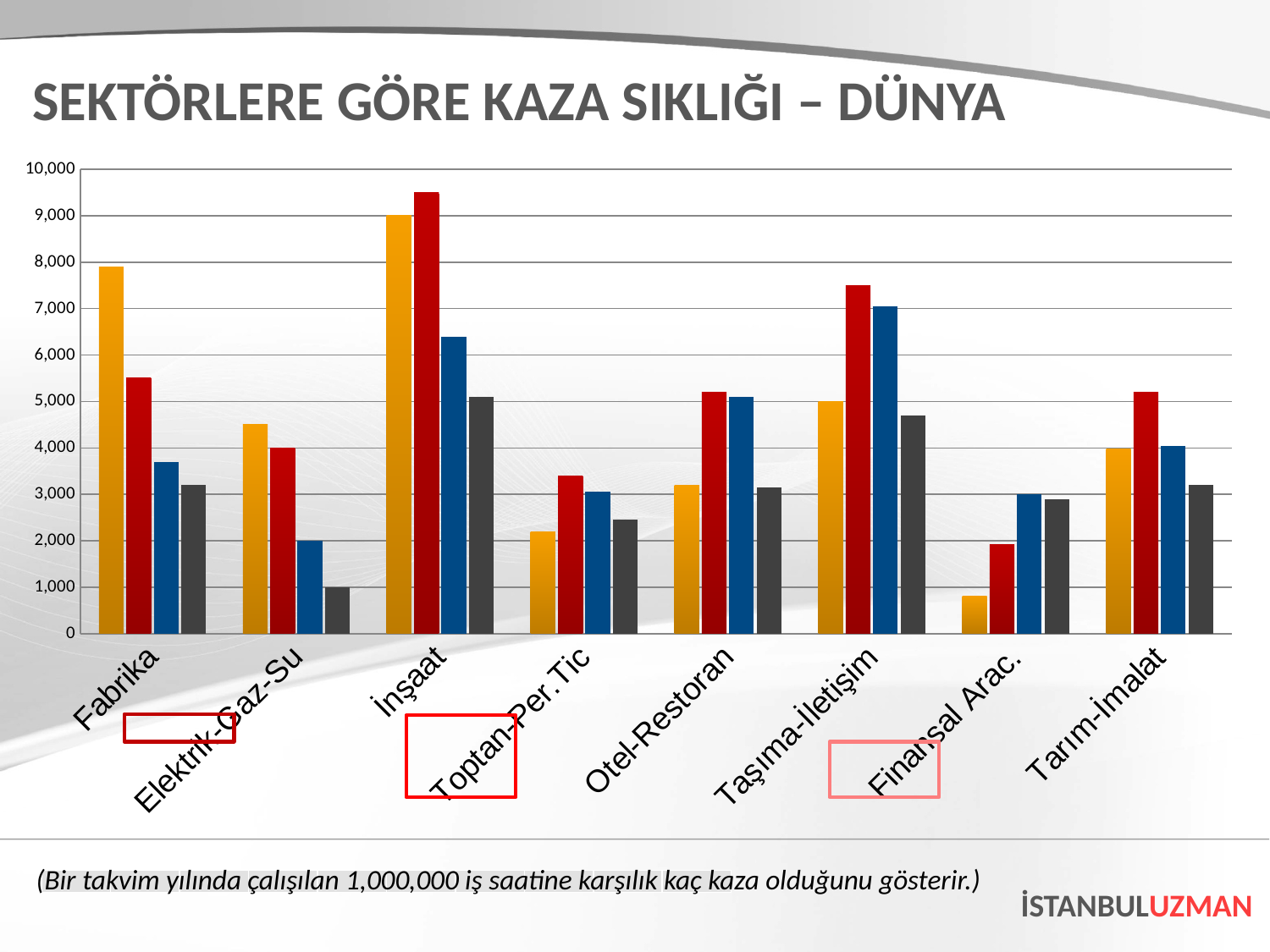
How many bars are plotted for each sector category? 4 Which is larger, the red bar for İnşaat or the red bar for Otel-Restoran? İnşaat Which is larger, the yellow bar for Fabrika or the yellow bar for Elektrik-Gaz-Su? Fabrika Is the yellow bar for Finansal Arac. greater or less than 1,000? less What kind of chart is shown on the slide? bar chart Is the yellow bar for Fabrika greater or less than 7,000? greater What is the title of the chart on the slide? SEKTÖRLERE GÖRE KAZA SIKLIĞI – DÜNYA Is the yellow bar for Toptan-Per.Tic greater or less than 3,000? less Which sector has the shortest bar in the chart? Finansal Arac. How many sector categories are shown on the x axis? 8 Which sector has the tallest bar in the chart? İnşaat